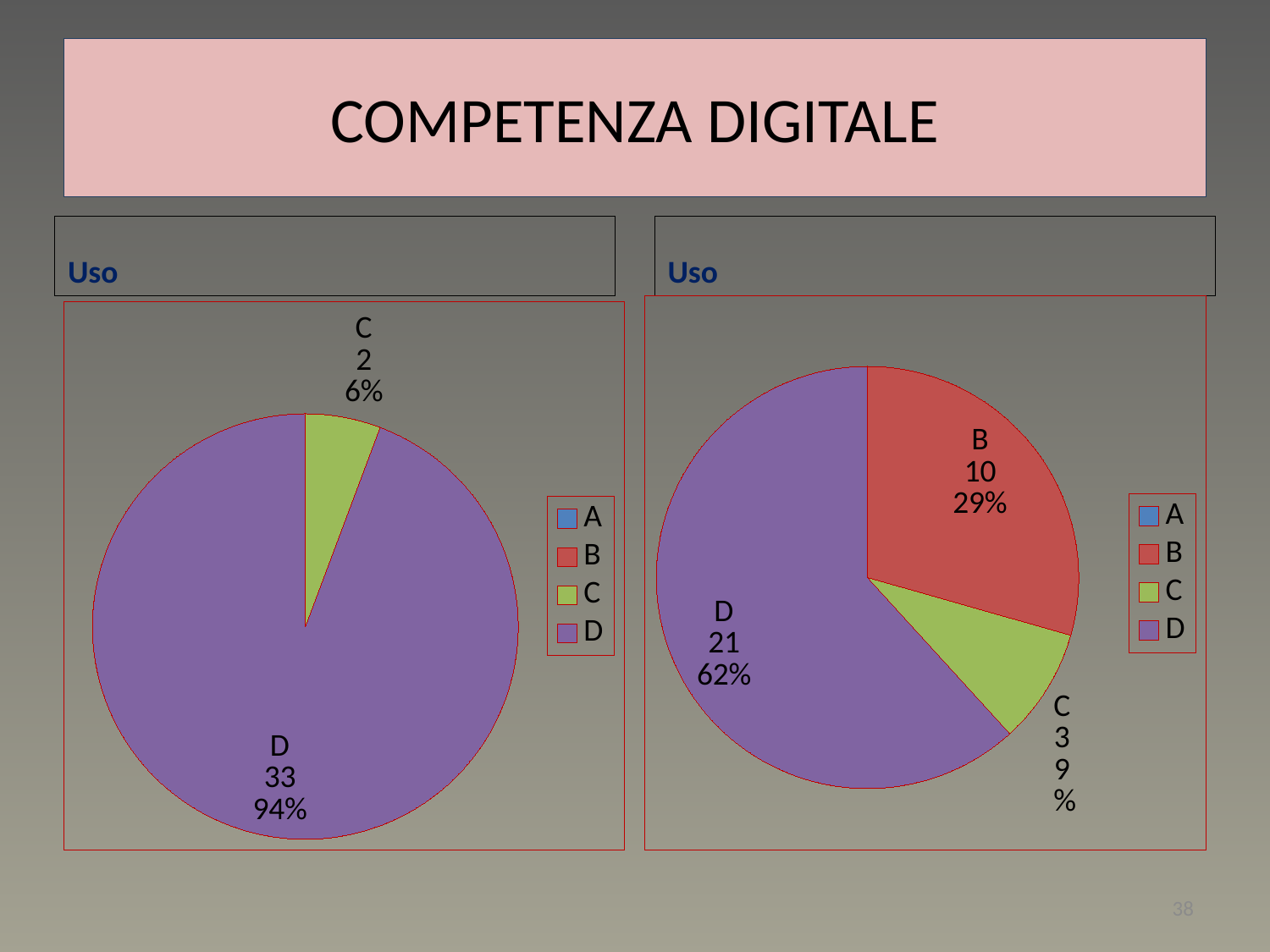
In the right pie chart, which category has the largest slice? D In the left pie chart, which is larger, the value for D or the value for C? D In the right pie chart, what value is shown for category C? 3 In the right pie chart, what value is shown for category B? 10 In the left pie chart, what value is shown for category D? 33 How many entries does the legend of the left chart list? 4 In the right pie chart, what is the difference between the values for D and B? 11 In the right pie chart, which category has the smallest labelled slice? C In the right pie chart, what percentage share does category D have? 62% What is the title shown above each of the two charts? Uso In the left pie chart, what percentage share does category C have? 6% What type of chart is shown on the right side of the slide? Pie chart